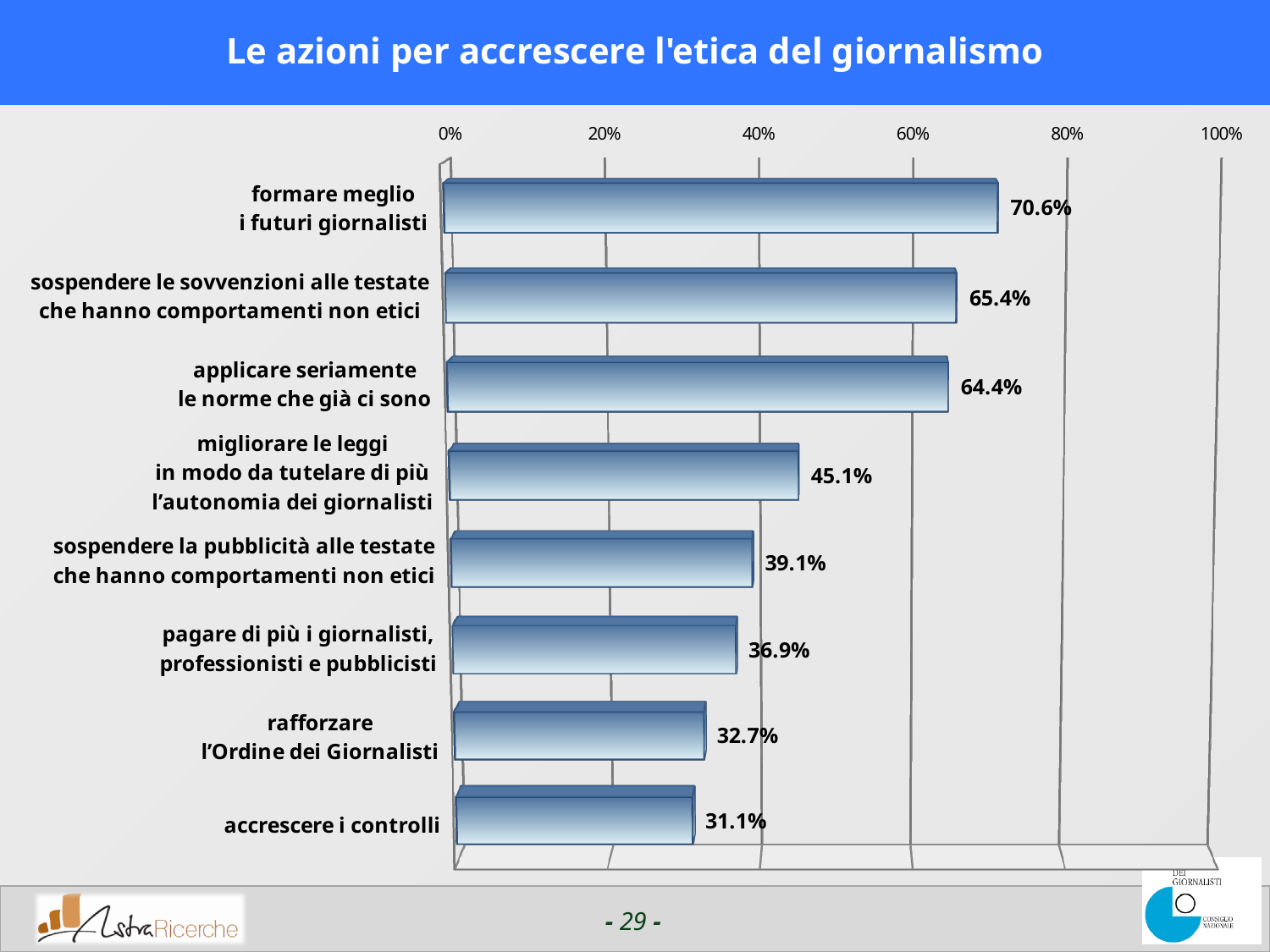
Which category has the lowest value? accrescere i controlli What kind of chart is shown on the slide? bar chart What is the difference between "sospendere le sovvenzioni alle testate che hanno comportamenti non etici" and "sospendere la pubblicità alle testate che hanno comportamenti non etici"? 26.3% What is the title of the slide? Le azioni per accrescere l'etica del giornalismo What is the value for "formare meglio i futuri giornalisti"? 70.6% What is the value for "accrescere i controlli"? 31.1% Which category has the highest value? formare meglio i futuri giornalisti What is the value for "rafforzare l'Ordine dei Giornalisti"? 32.7% Is the value for "pagare di più i giornalisti, professionisti e pubblicisti" greater or less than 40%? less Which is larger: "applicare seriamente le norme che già ci sono" or "migliorare le leggi in modo da tutelare di più l'autonomia dei giornalisti"? applicare seriamente le norme che già ci sono How many categories are shown in the chart? 8 What is the difference between the highest and lowest values in the chart? 39.5%